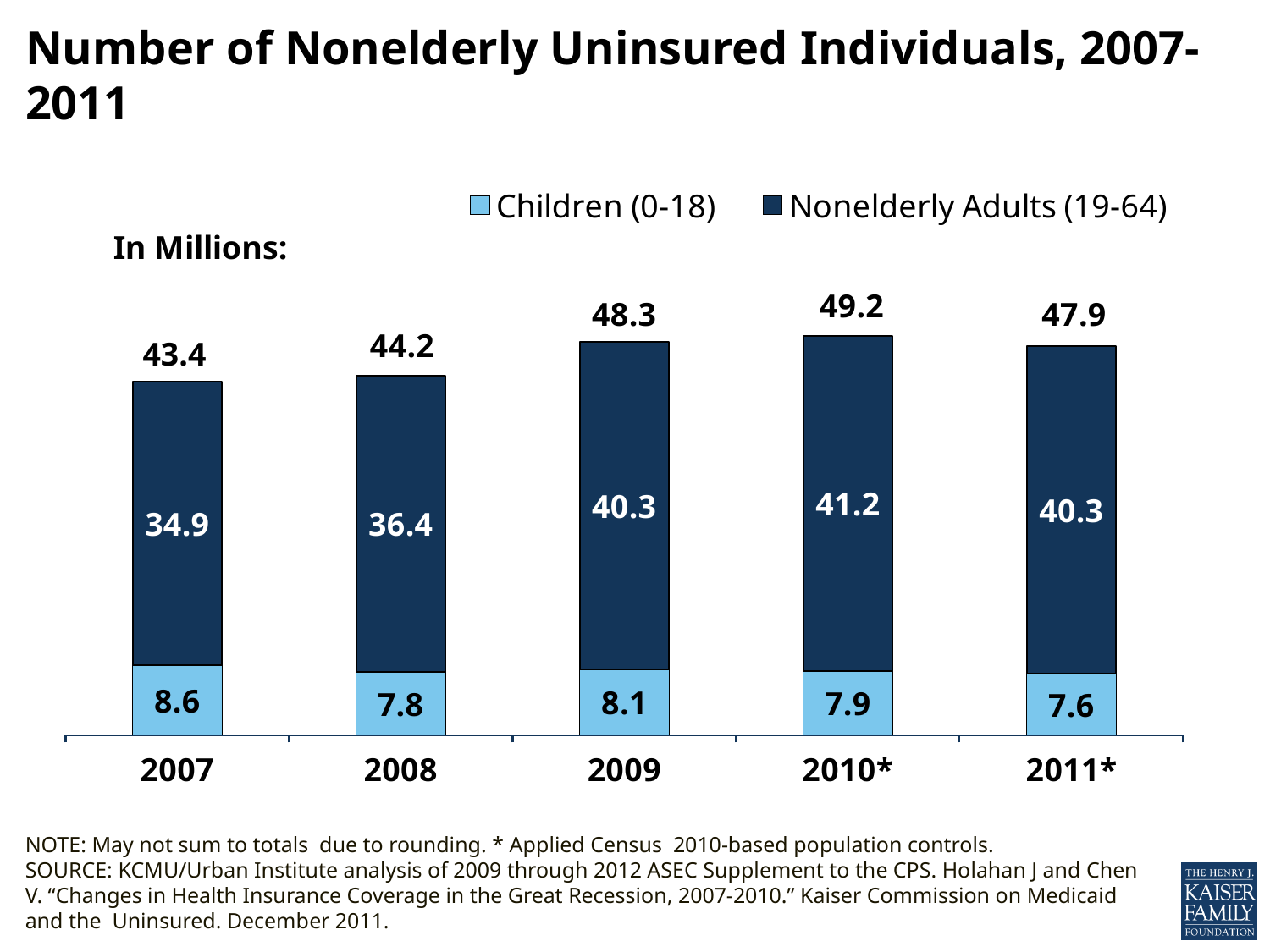
How many years are shown on the x axis? 5 What is the value for Children (0-18) in 2007? 8.6 What is the difference between the Nonelderly Adults (19-64) values for 2008 and 2007? 1.5 What is the total shown above the bar for 2009? 48.3 Do the Nonelderly Adults (19-64) values rise or fall from 2007 to 2010*? Rise Which year has the lowest value for Children (0-18)? 2011* How many series does the legend list? 2 What is the value for Nonelderly Adults (19-64) in 2010*? 41.2 Which is larger, the Children (0-18) value for 2009 or for 2010*? 2009 Which year has the highest total number of nonelderly uninsured individuals? 2010* What kind of chart is shown on the slide? Stacked bar chart What unit are the values on the chart expressed in? Millions